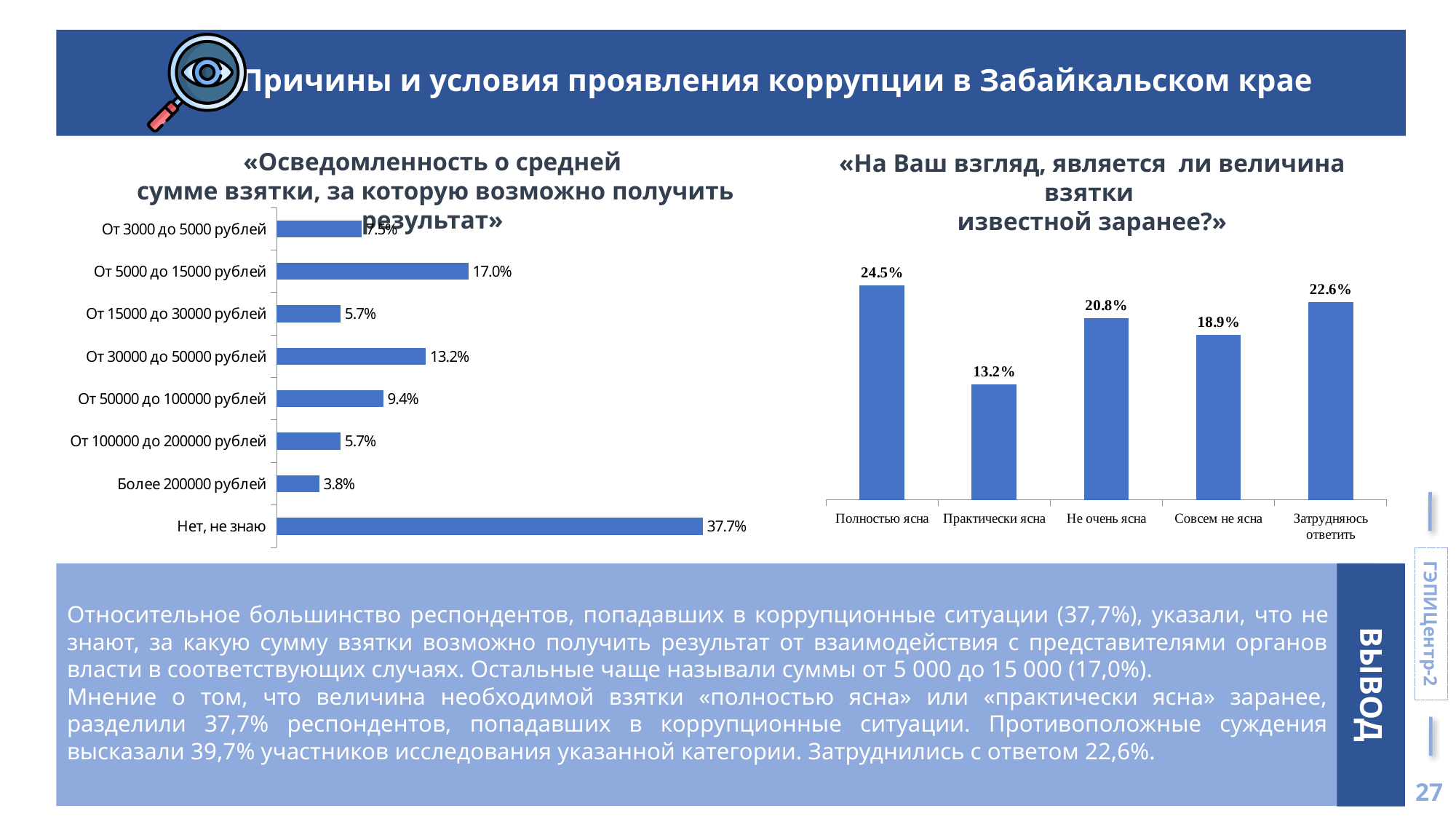
In the right chart «На Ваш взгляд, является ли величина взятки известной заранее?», which category has the lowest value? Практически ясна In the right chart «На Ваш взгляд, является ли величина взятки известной заранее?», which category has the highest value? Полностью ясна In the left chart «Осведомленность о средней сумме взятки...», what is the value for «От 5000 до 15000 рублей»? 17.0% In the left chart «Осведомленность о средней сумме взятки...», which category has the lowest value? Более 200000 рублей In the right chart «На Ваш взгляд, является ли величина взятки известной заранее?», what is the value for «Не очень ясна»? 20.8% In the right chart «На Ваш взгляд, является ли величина взятки известной заранее?», what is the difference between «Полностью ясна» and «Практически ясна»? 11.3% In the left chart «Осведомленность о средней сумме взятки...», what is the value for «Нет, не знаю»? 37.7% In the left chart «Осведомленность о средней сумме взятки...», which category has the highest value? Нет, не знаю In the right chart «На Ваш взгляд, является ли величина взятки известной заранее?», which is larger: «Совсем не ясна» or «Затрудняюсь ответить»? Затрудняюсь ответить What kind of chart is the left chart «Осведомленность о средней сумме взятки...»? Bar chart In the left chart «Осведомленность о средней сумме взятки...», what is the difference between «От 30000 до 50000 рублей» and «От 50000 до 100000 рублей»? 3.8% In the left chart «Осведомленность о средней сумме взятки...», how many categories are shown? 8